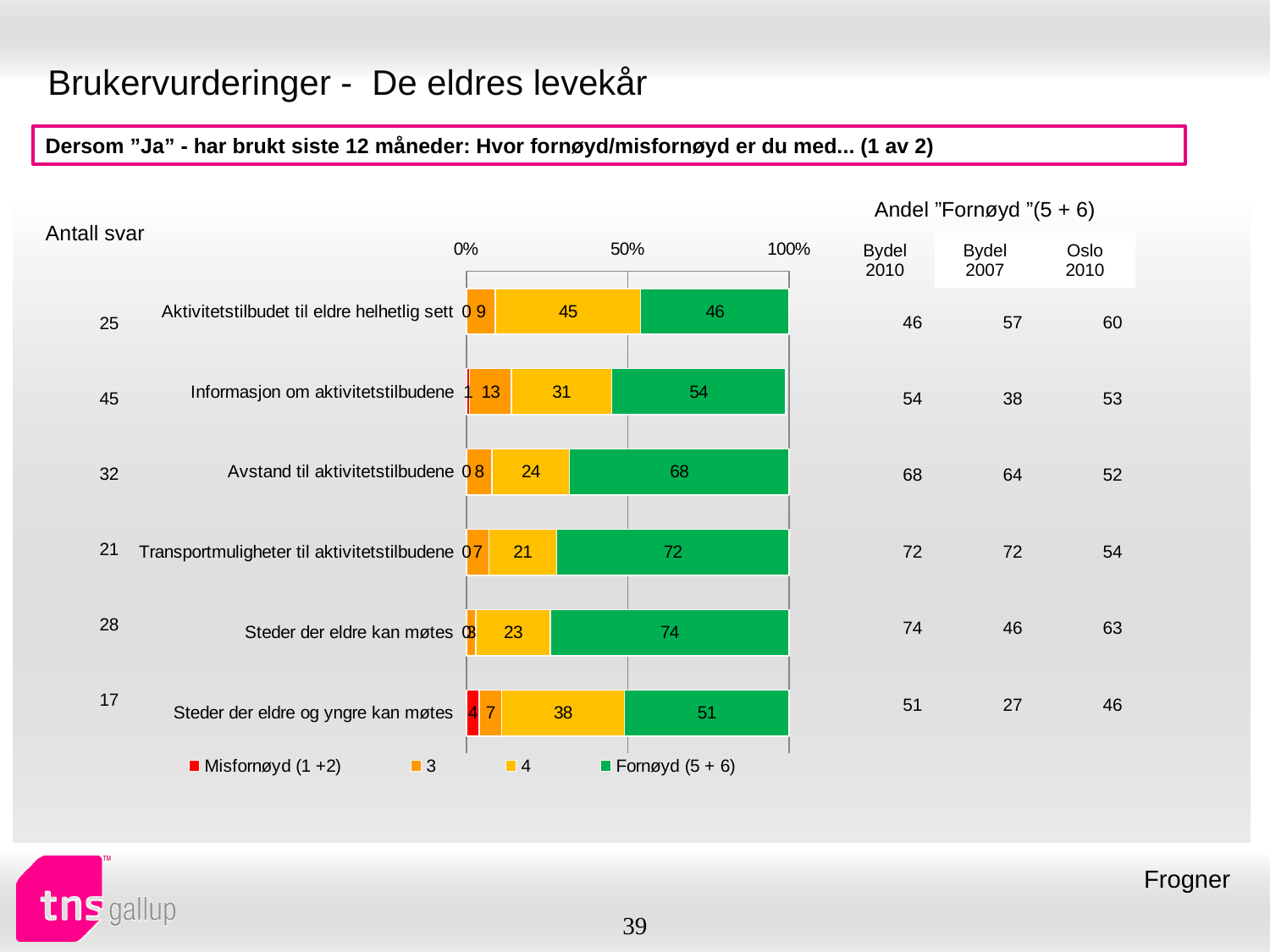
Which category has the lowest 'Fornøyd (5 + 6)' value? Aktivitetstilbudet til eldre helhetlig sett What type of chart is shown on the slide? stacked bar chart Which category has the highest 'Fornøyd (5 + 6)' value? Steder der eldre kan møtes What is the 'Fornøyd (5 + 6)' value for 'Avstand til aktivitetstilbudene'? 68 What is the value of series '3' for 'Informasjon om aktivitetstilbudene'? 13 What is the difference between the 'Fornøyd (5 + 6)' values for 'Transportmuligheter til aktivitetstilbudene' and 'Informasjon om aktivitetstilbudene'? 18 What is the 'Fornøyd (5 + 6)' value for 'Steder der eldre og yngre kan møtes'? 51 How many series does the legend of the bar chart list? 4 Which is larger: the 'Fornøyd (5 + 6)' value for 'Avstand til aktivitetstilbudene' or for 'Steder der eldre og yngre kan møtes'? Avstand til aktivitetstilbudene What is the value of series '4' for 'Aktivitetstilbudet til eldre helhetlig sett'? 45 What is the first entry in the chart's legend? Misfornøyd (1 +2) How many categories does the bar chart show? 6